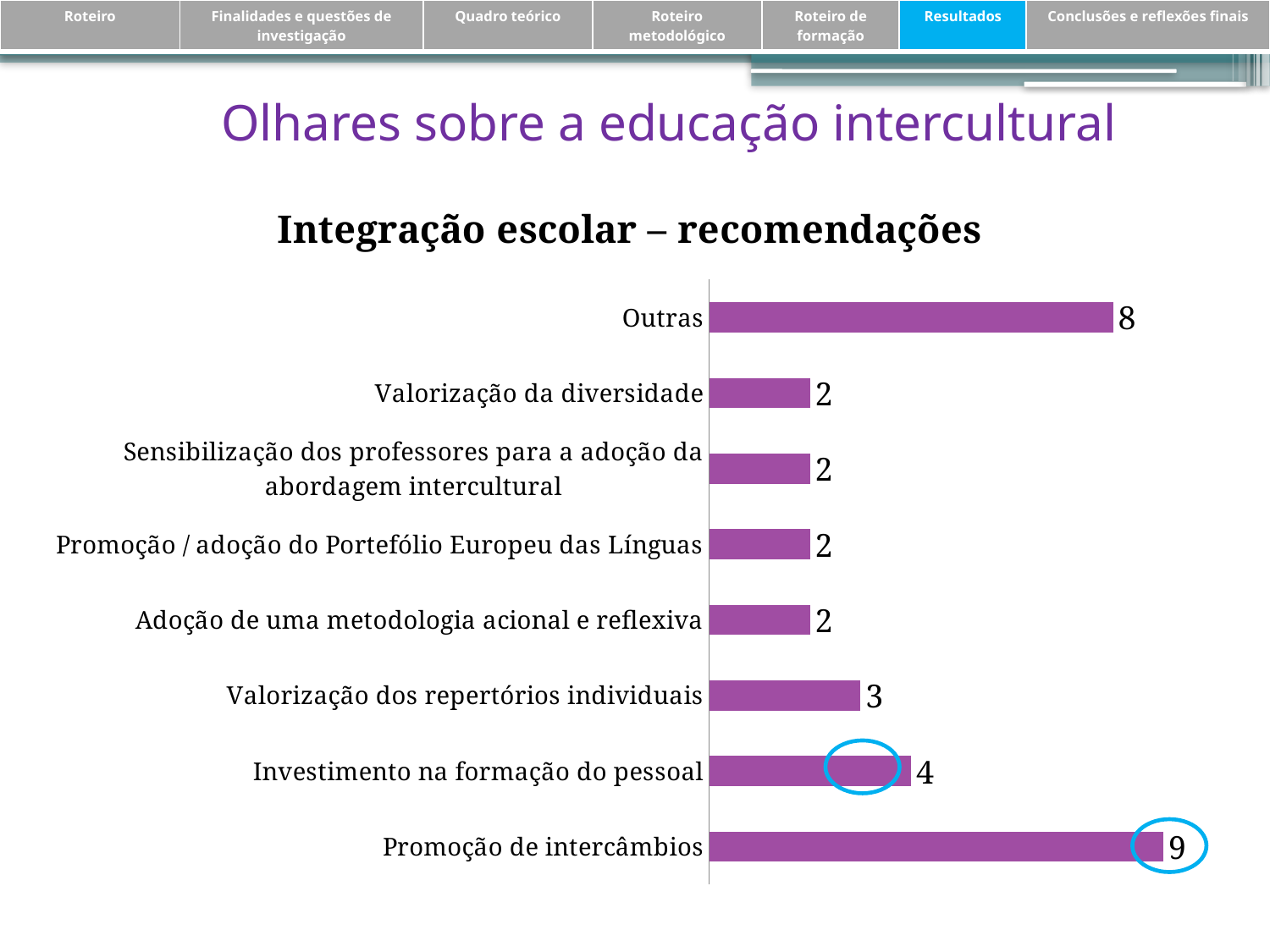
What is the title of the chart? Integração escolar – recomendações What kind of chart is shown on the slide? Bar chart What is the difference between the values for Investimento na formação do pessoal and Valorização dos repertórios individuais? 1 Which is larger, the value for Outras or the value for Investimento na formação do pessoal? Outras What is the value for Valorização dos repertórios individuais? 3 What is the value for Valorização da diversidade? 2 What is the value for Promoção de intercâmbios? 9 How many categories are shown in the chart? 8 Which category has the highest value? Promoção de intercâmbios What is the value for Investimento na formação do pessoal? 4 What is the difference between the values for Promoção de intercâmbios and Outras? 1 What is the value for Outras? 8